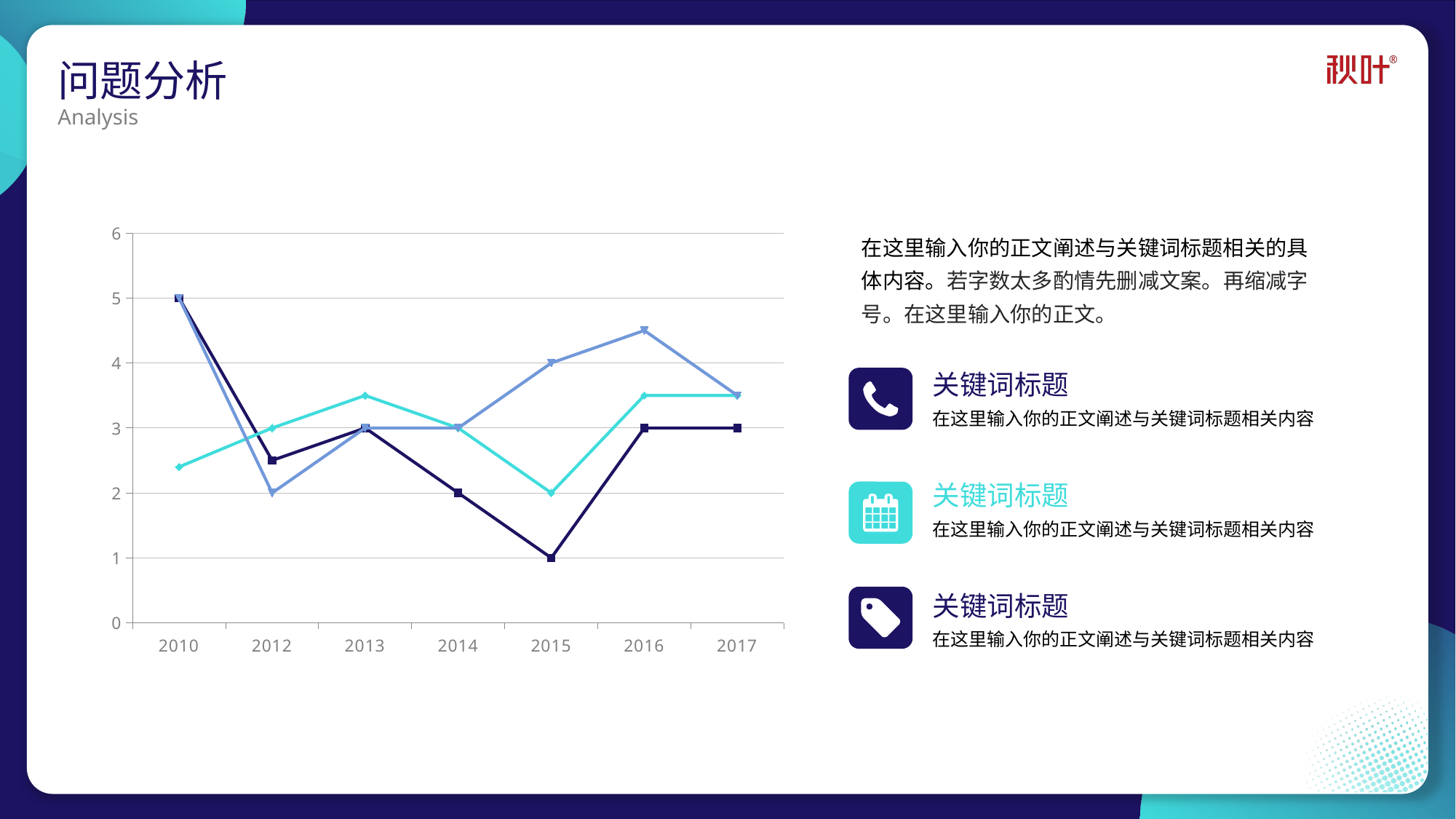
In 2015, which line has the higher value: the light blue line with triangle markers or the dark navy line with square markers? the light blue line with triangle markers How many years are shown on the x axis of the chart? 7 What is the value of the dark navy line with square markers in 2010? 5 Is the value of the light blue line with triangle markers in 2016 greater or less than 4? greater Is the value of the cyan line with diamond markers in 2010 greater or less than 3? less What kind of chart is shown on the slide? line chart How many lines are plotted on the chart? 3 What is the value of the dark navy line with square markers in 2015? 1 What is the value of the cyan line with diamond markers in 2015? 2 In which year is the light blue line with triangle markers at its highest? 2010 In which year is the dark navy line with square markers at its lowest? 2015 Does the light blue line with triangle markers rise or fall from 2013 to 2016? rise